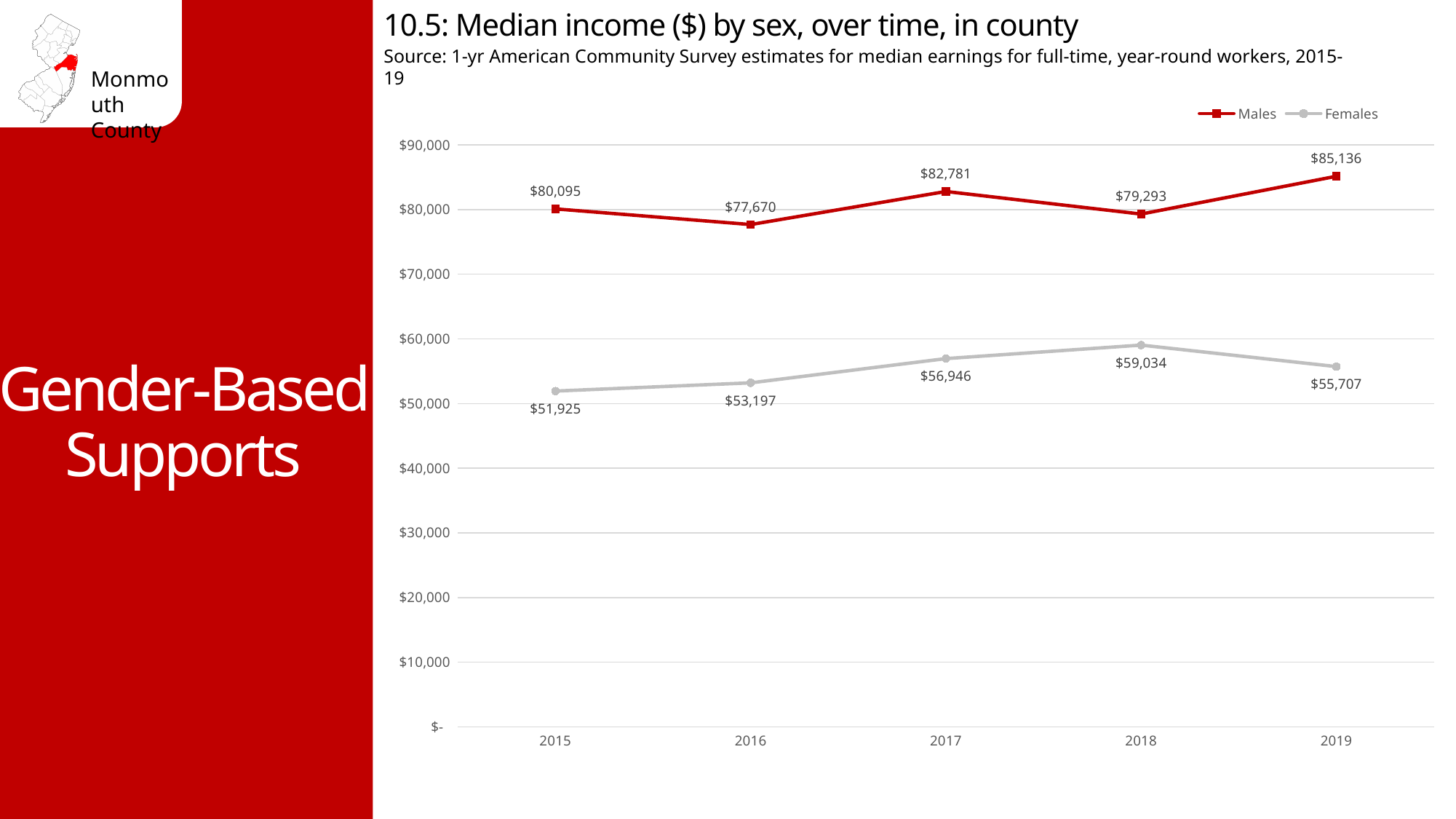
How many series does the legend list? 2 What is the median income for Females in 2015? $51,925 What kind of chart is shown? line chart In which year is the median income for Females the highest? 2018 In which year is the median income for Males the lowest? 2016 Which is larger, the Males median income in 2017 or in 2018? 2017 Is the median income for Females in 2018 greater or less than $60,000? less Does the Females median income rise or fall from 2015 to 2018? rise What is the difference between the Males and Females median income in 2019? $29,429 How many years are shown on the x axis? 5 What is the median income for Males in 2019? $85,136 What is the median income for Females in 2017? $56,946